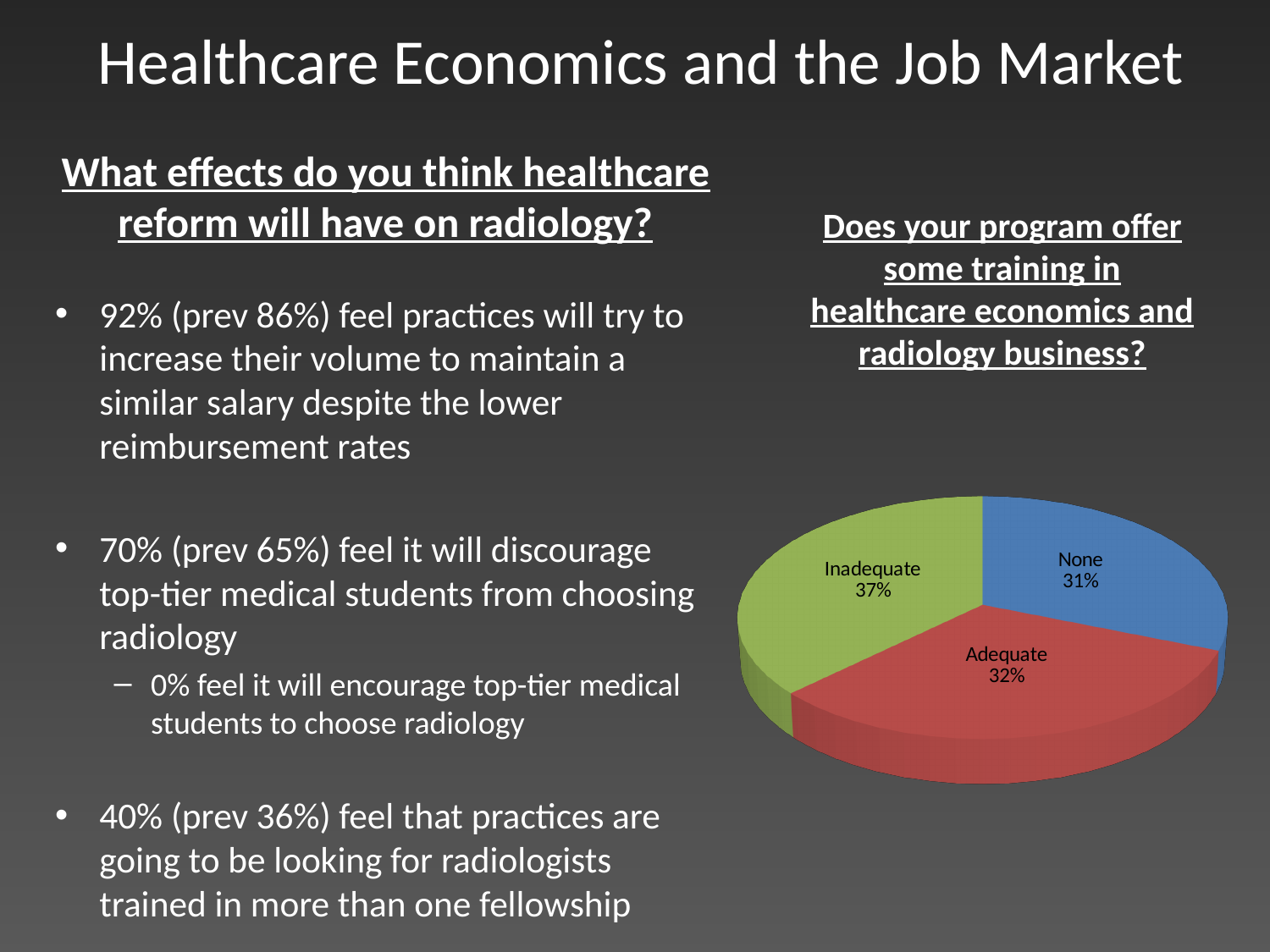
How many slices does the pie chart have? 3 What share of the pie is labelled "Adequate"? 32% What share of the pie is labelled "Inadequate"? 37% What colour is the Adequate slice of the pie chart? Red What share of the pie is labelled "None"? 31% Which slice of the pie chart is the smallest? None Which slice is larger, Inadequate or Adequate? Inadequate What kind of chart is shown on the slide? Pie chart What is the title of the pie chart? Does your program offer some training in healthcare economics and radiology business? Which slice of the pie chart is the largest? Inadequate What is the difference in percentage points between the Inadequate and None slices? 6 What is the difference in percentage points between the Adequate and None slices? 1